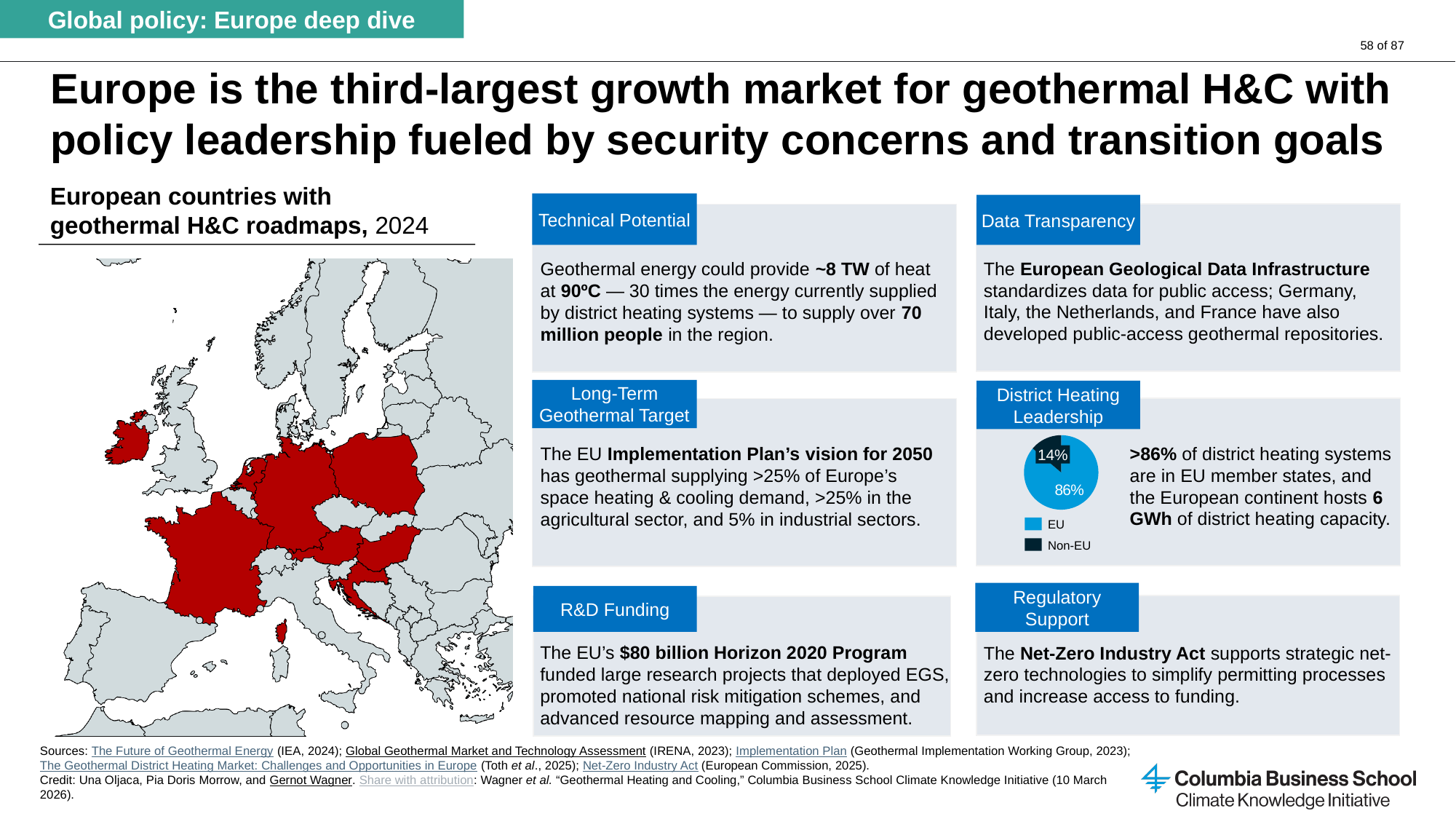
How many entries does the legend of the pie chart in the District Heating Leadership box list? 2 In the pie chart in the District Heating Leadership box, what colour is the EU slice? Light blue In the pie chart in the District Heating Leadership box, what share of the pie does the EU slice represent? 86% In the pie chart in the District Heating Leadership box, which slice is the smallest? Non-EU In the pie chart in the District Heating Leadership box, what is the difference in percentage points between the EU and Non-EU slices? 72 percentage points How many slices does the pie chart in the District Heating Leadership box have? 2 In the pie chart in the District Heating Leadership box, which is larger, the EU slice or the Non-EU slice? EU In the pie chart in the District Heating Leadership box, which slice is the largest? EU In the pie chart in the District Heating Leadership box, what share is labelled for EU? 86% What kind of chart is shown in the District Heating Leadership box? Pie chart In the pie chart in the District Heating Leadership box, what colour is the Non-EU slice? Dark navy In the pie chart in the District Heating Leadership box, what share is labelled for Non-EU? 14%